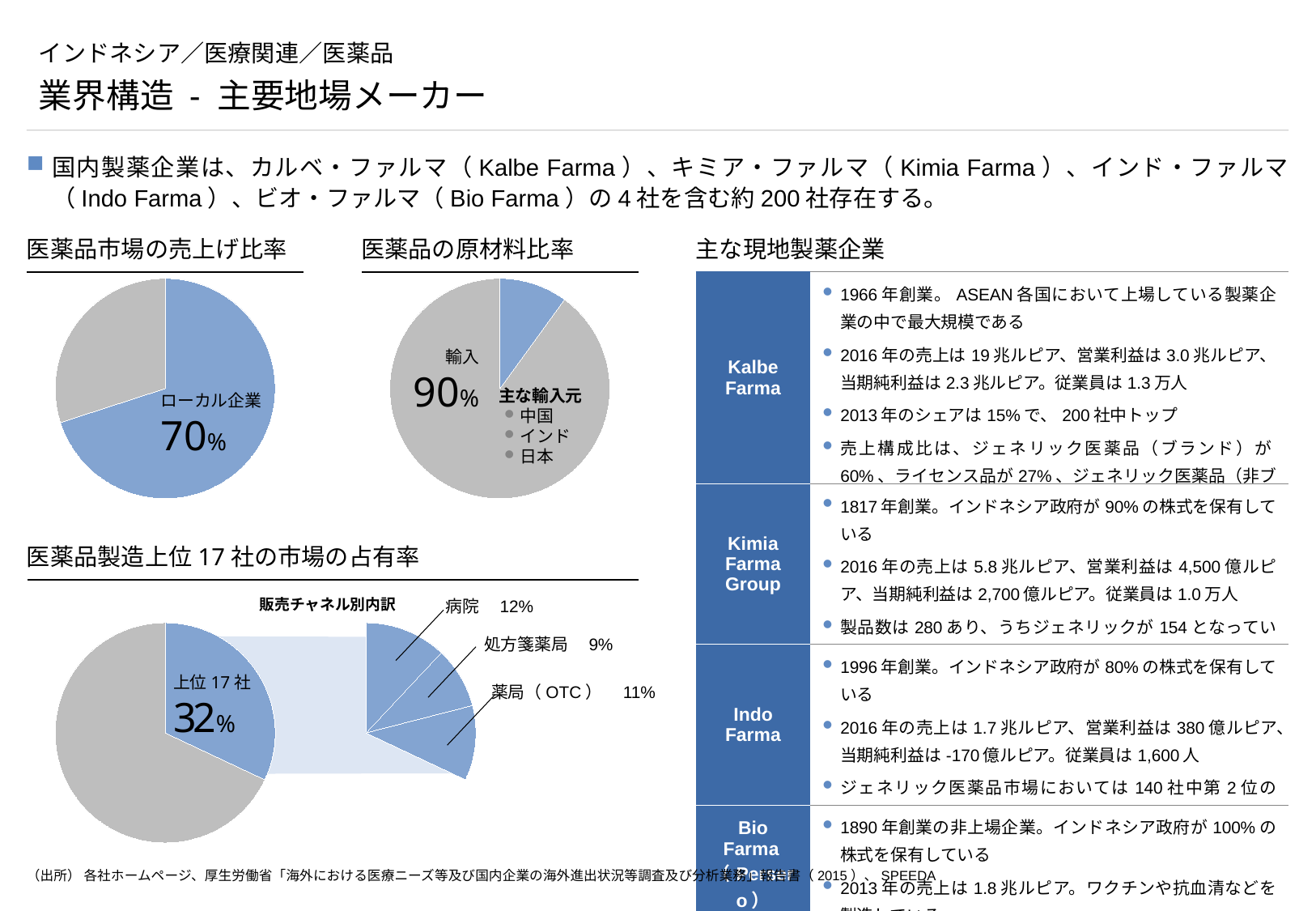
In the chart titled 医薬品製造上位17社の市場の占有率, what share of the market is held by 上位17社? 32% In the chart titled 医薬品市場の売上げ比率, what share of the market is held by ローカル企業? 70% In the chart titled 医薬品の原材料比率, is the 輸入 slice greater or less than 50%? greater In the chart titled 医薬品製造上位17社の市場の占有率, what is the share for 病院 in the 販売チャネル別内訳 breakdown? 12% In the chart titled 医薬品製造上位17社の市場の占有率, what is the difference between the 病院 share and the 処方箋薬局 share? 3% In the chart titled 医薬品製造上位17社の市場の占有率, what is the share for 薬局（OTC） in the 販売チャネル別内訳 breakdown? 11% In the chart titled 医薬品製造上位17社の市場の占有率, how many sales channels are shown in the 販売チャネル別内訳 breakdown? 3 What kind of chart is the chart titled 医薬品市場の売上げ比率? pie chart In the chart titled 医薬品の原材料比率, what share is labelled 輸入? 90% In the chart titled 医薬品製造上位17社の市場の占有率, which sales channel in the 販売チャネル別内訳 breakdown has the smallest share? 処方箋薬局 In the chart titled 医薬品製造上位17社の市場の占有率, what is the share for 処方箋薬局 in the 販売チャネル別内訳 breakdown? 9% In the chart titled 医薬品製造上位17社の市場の占有率, which sales channel in the 販売チャネル別内訳 breakdown has the largest share? 病院